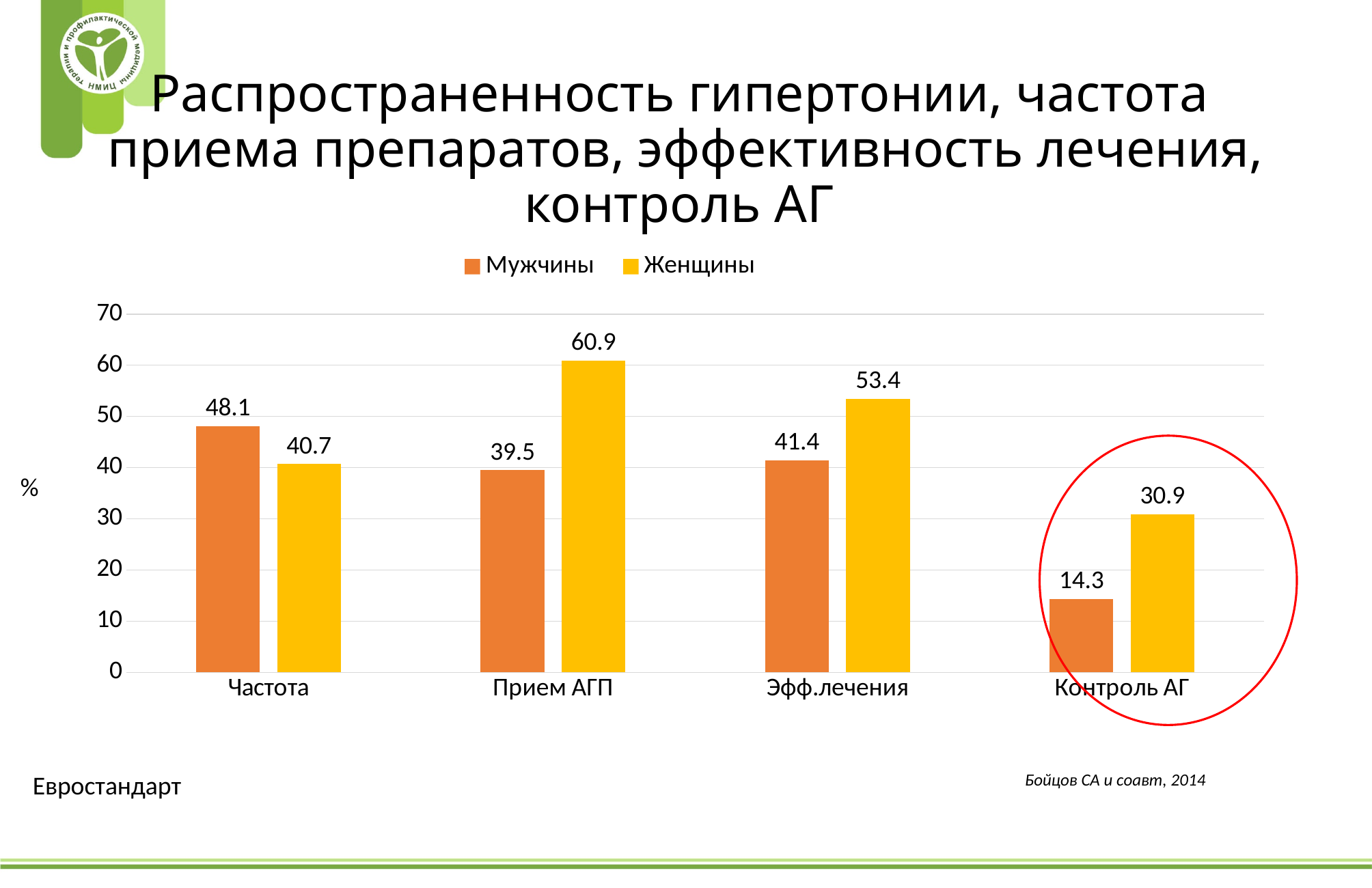
What is the value for Женщины in the Прием АГП category? 60.9 What is the difference between the Женщины and Мужчины values in the Контроль АГ category? 16.6 How many series does the legend list? 2 Which category is circled in red on the chart? Контроль АГ What is the value for Женщины in the Эфф.лечения category? 53.4 What kind of chart is shown on the slide? Bar chart Which category has the lowest value for Мужчины? Контроль АГ What is the value for Мужчины in the Контроль АГ category? 14.3 What is the value for Мужчины in the Частота category? 48.1 Which is larger in the Частота category, the value for Мужчины or for Женщины? Мужчины How many categories are shown on the x axis? 4 Which category has the highest value for Женщины? Прием АГП